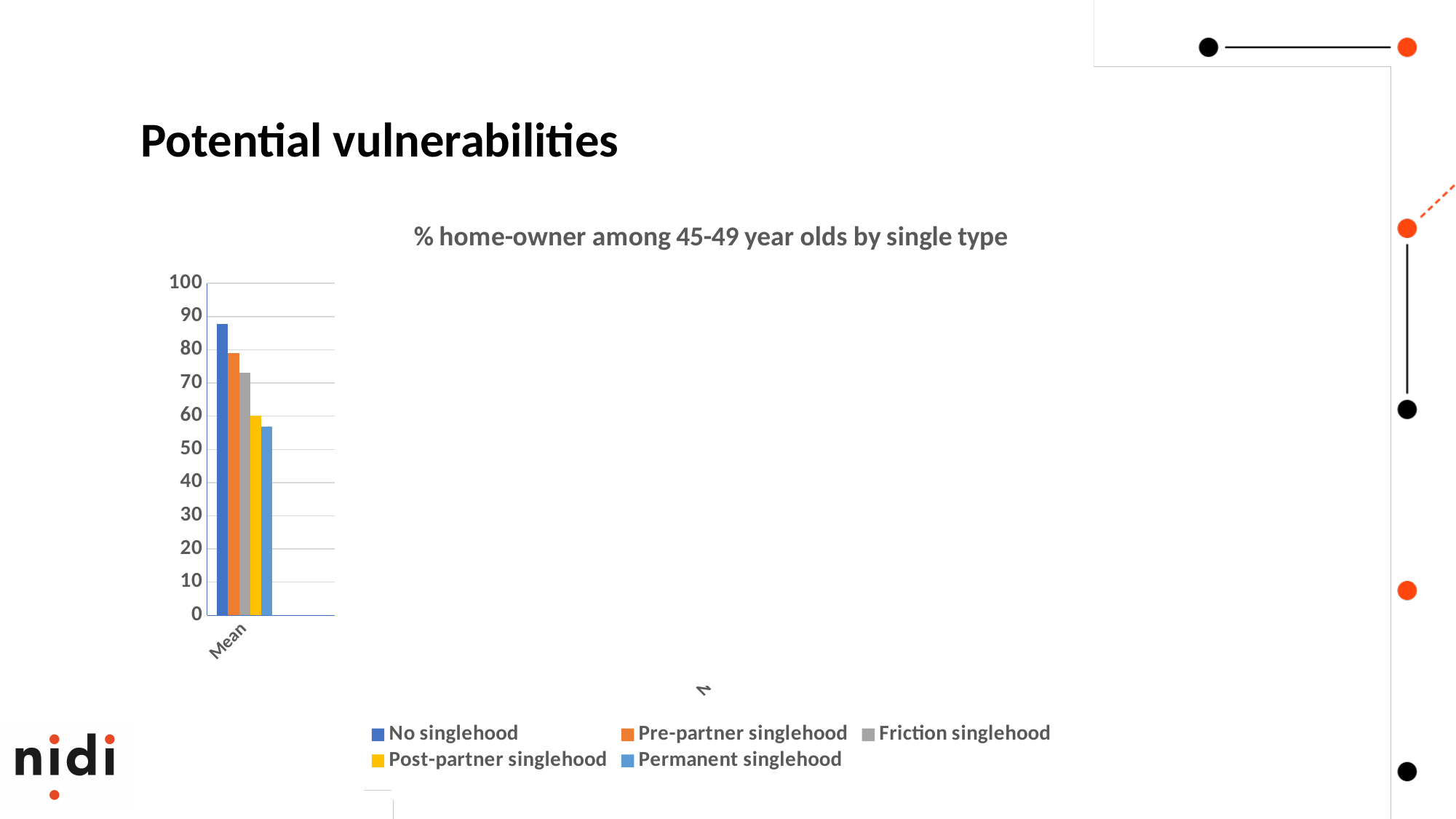
Is the value for Permanent singlehood greater or less than 60? less Is the value for Post-partner singlehood greater or less than 70? less Which single type has the highest % home-owner value? No singlehood What kind of chart is shown on the slide? Bar chart Which is larger, the value for Pre-partner singlehood or the value for Friction singlehood? Pre-partner singlehood What is the label of the category on the x axis? Mean Is the value for No singlehood greater or less than 80? greater What is the title of the chart? % home-owner among 45-49 year olds by single type Which single type has the lowest % home-owner value? Permanent singlehood How many series does the chart's legend list? 5